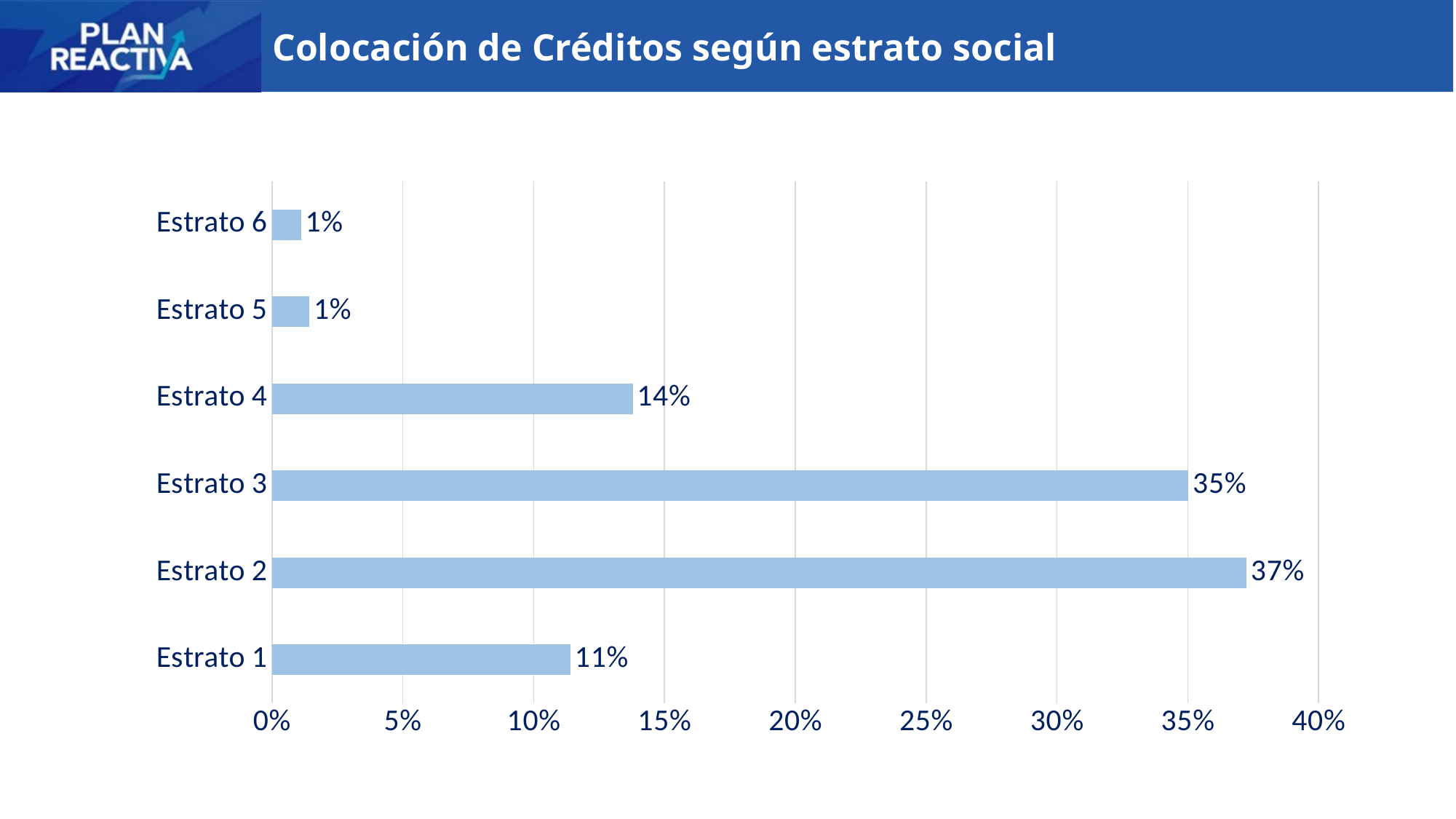
Which category has the highest value? Estrato 2 What is the title of the slide? Colocación de Créditos según estrato social What is the difference between the values for Estrato 2 and Estrato 3? 2% What is the value for Estrato 4? 14% What is the value for Estrato 3? 35% How many categories are shown in the chart? 6 Which is larger, the value for Estrato 1 or the value for Estrato 4? Estrato 4 What is the difference between the values for Estrato 4 and Estrato 1? 3% What kind of chart is shown on the slide? bar chart Is the value for Estrato 3 greater or less than 30%? greater What is the value for Estrato 2? 37% What is the value for Estrato 1? 11%